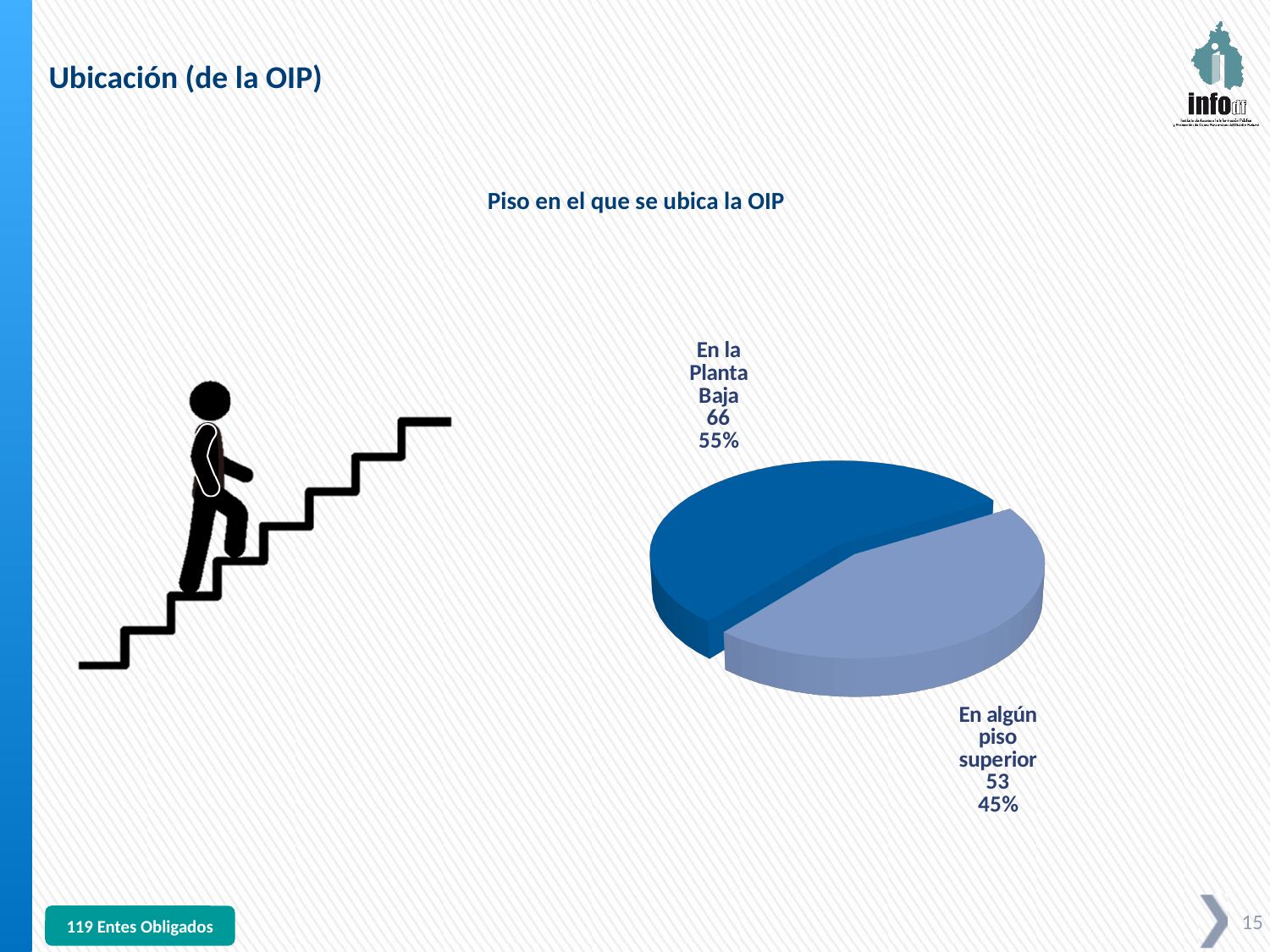
How many slices does the pie chart have? 2 What is the total of the two slice values? 119 What is the difference between the values for 'En la Planta Baja' and 'En algún piso superior'? 13 What is the title of the chart? Piso en el que se ubica la OIP What kind of chart is shown on the slide? Pie chart What is the value for 'En algún piso superior'? 53 Which is larger, the value for 'En la Planta Baja' or 'En algún piso superior'? En la Planta Baja What share of the pie does 'En algún piso superior' represent? 45% What share of the pie does 'En la Planta Baja' represent? 55% What is the value for 'En la Planta Baja'? 66 Which category has the largest slice? En la Planta Baja Which category has the smallest slice? En algún piso superior